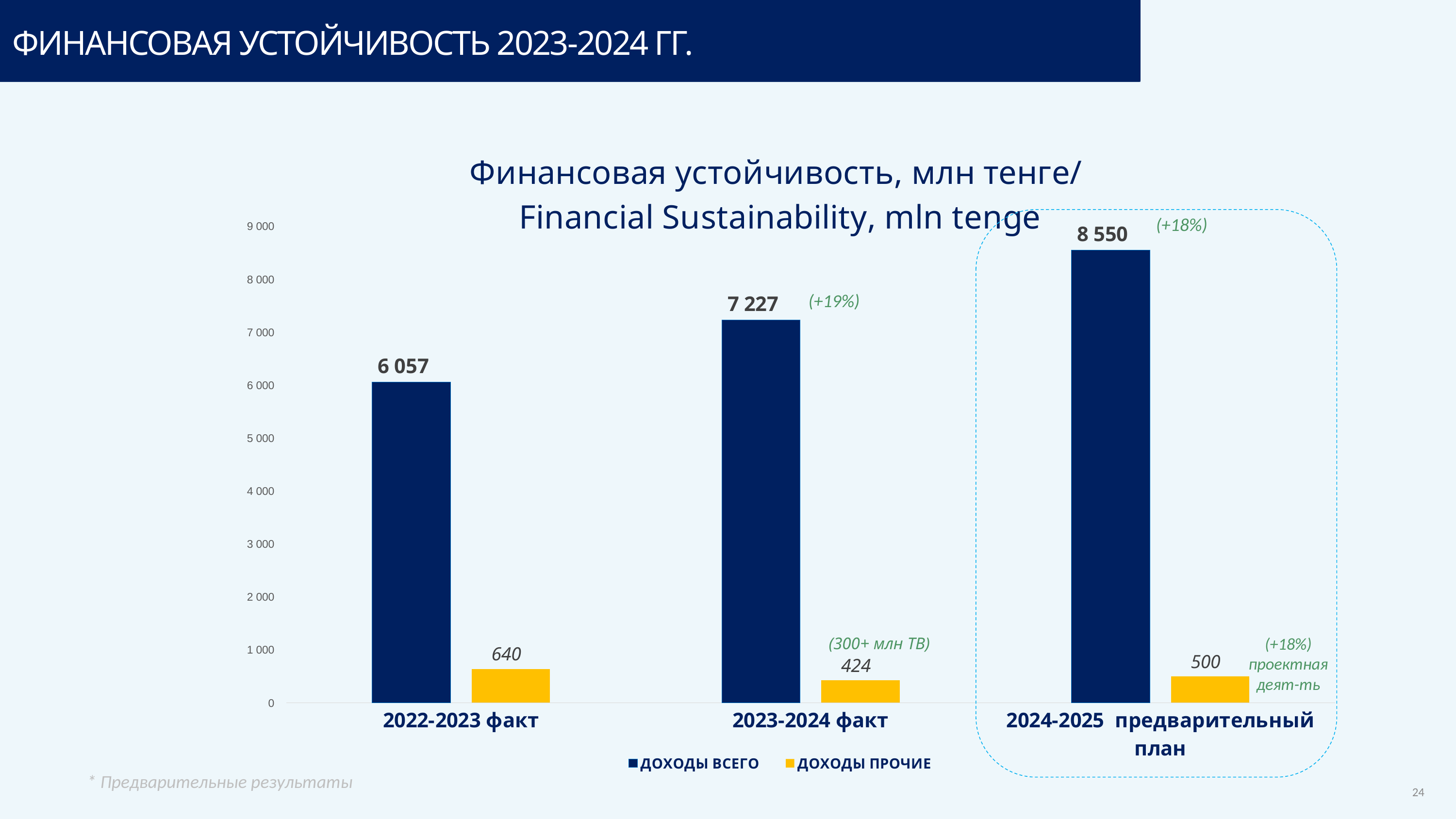
What is the value of ДОХОДЫ ВСЕГО for 2023-2024 факт? 7 227 Is the value of ДОХОДЫ ВСЕГО for 2023-2024 факт greater or less than 7 000? greater Which category has the lowest value for ДОХОДЫ ПРОЧИЕ? 2023-2024 факт What is the value of ДОХОДЫ ВСЕГО for 2022-2023 факт? 6 057 How many categories are shown on the x axis? 3 What is the value of ДОХОДЫ ПРОЧИЕ for 2023-2024 факт? 424 Which is larger: ДОХОДЫ ПРОЧИЕ for 2022-2023 факт or for 2024-2025 предварительный план? 2022-2023 факт Does ДОХОДЫ ВСЕГО rise or fall across the categories from left to right? rise Which category has the highest value for ДОХОДЫ ВСЕГО? 2024-2025 предварительный план What is the value of ДОХОДЫ ПРОЧИЕ for 2024-2025 предварительный план? 500 How many series does the legend list? 2 What is the difference between ДОХОДЫ ВСЕГО for 2024-2025 предварительный план and 2023-2024 факт? 1 323